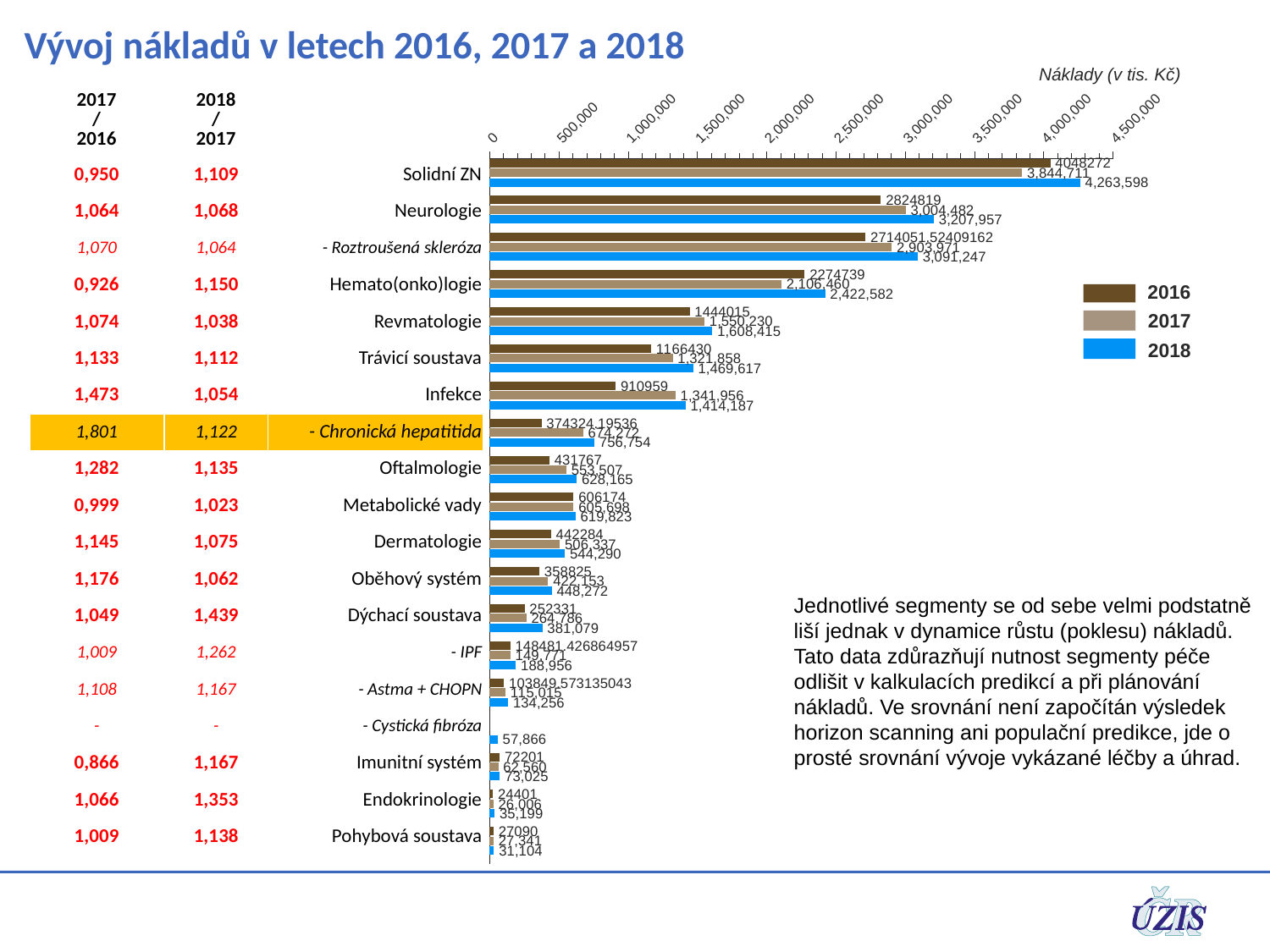
What type of chart is shown on the slide? bar chart How many categories are shown on the chart? 19 What is the 2018 value for Cystická fibróza? 57,866 What is the difference between the 2018 and 2017 values for Solidní ZN? 418,887 What is the 2017 value for Neurologie? 3,004,482 What is the 2018 value for Infekce? 1,414,187 Which category has the highest 2018 value? Solidní ZN Which category has the lowest 2018 value? Pohybová soustava Is the 2018 value for Hemato(onko)logie greater or less than 2,000,000? greater How many series does the chart legend list? 3 Which is larger: the 2018 value for Revmatologie or the 2018 value for Trávicí soustava? Revmatologie What is the 2018 value for Solidní ZN? 4,263,598